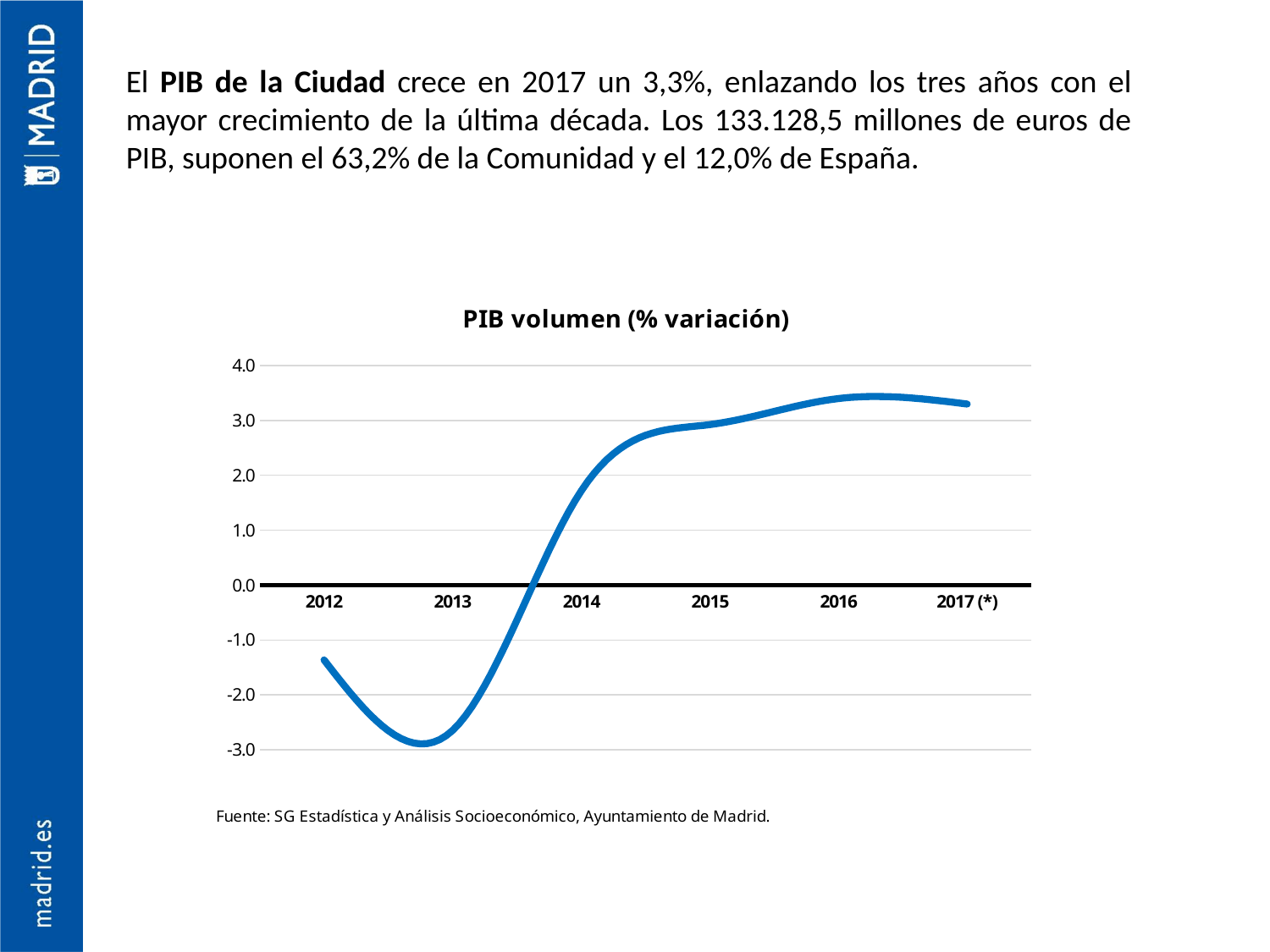
Which year has the lowest value in the chart? 2013 How many years are plotted on the x axis of the chart? 6 What type of chart is shown on the slide? Line chart What is the title of the chart? PIB volumen (% variación) Is the value for 2013 greater or less than -2.0? less Is the value for 2014 greater or less than 1.0? greater Is the value for 2017 (*) greater or less than 3.0? greater Which is larger, the value for 2014 or the value for 2015? 2015 Which is larger, the value for 2012 or the value for 2013? 2012 Do the values rise or fall between 2013 and 2016? rise